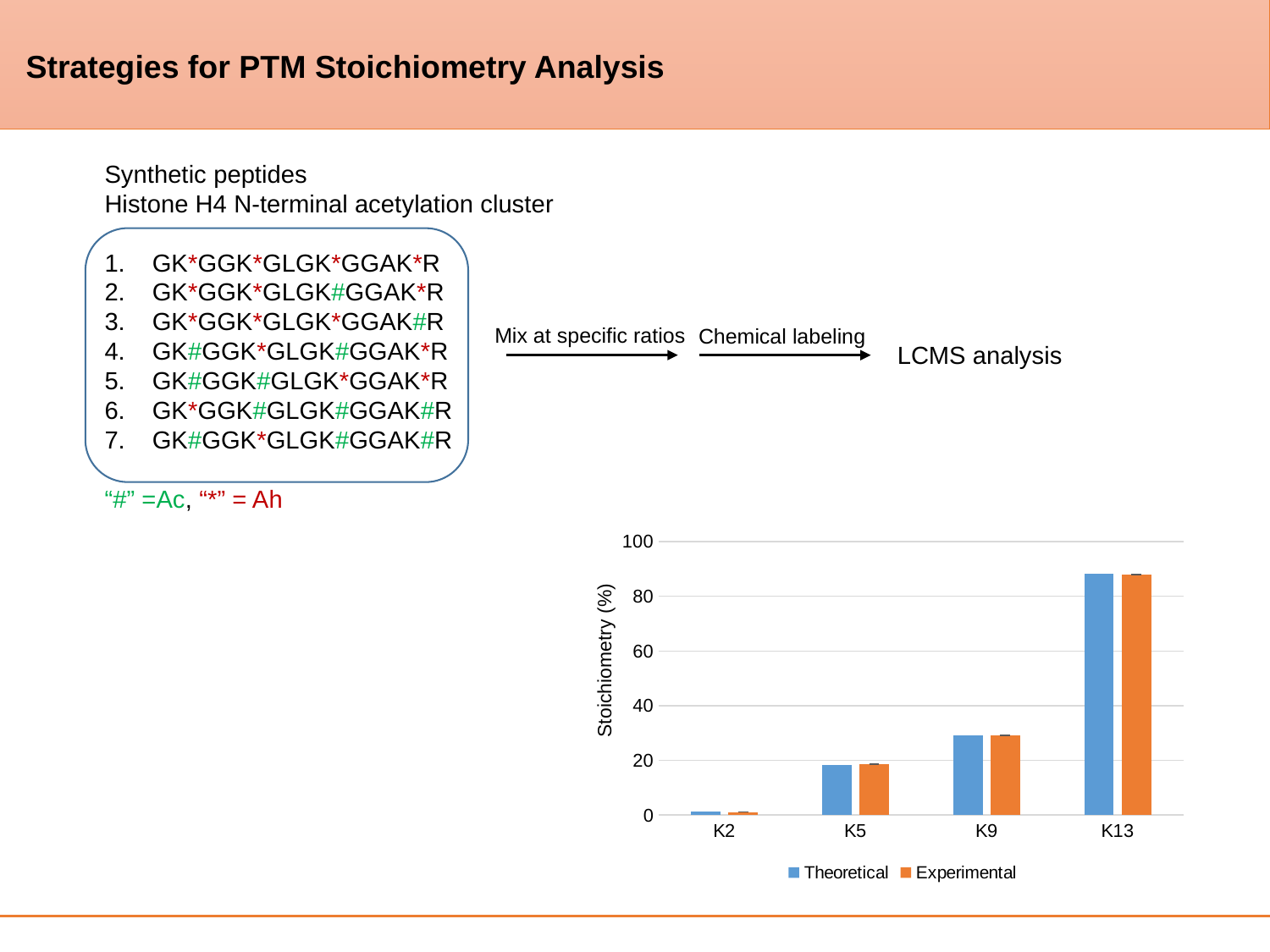
What kind of chart is shown on the slide? bar chart Is the Experimental value for K5 greater or less than 20? less How many categories are shown on the x axis of the chart? 4 Do the Theoretical values rise or fall from K2 to K13? rise Which category has the highest Theoretical stoichiometry? K13 Is the Theoretical value for K9 greater or less than 20? greater Which category has the lowest Experimental stoichiometry? K2 Is the Experimental value for K13 greater or less than 100? less How many series does the chart's legend list? 2 What is the label of the chart's y axis? Stoichiometry (%) Which series is shown in orange in the chart? Experimental